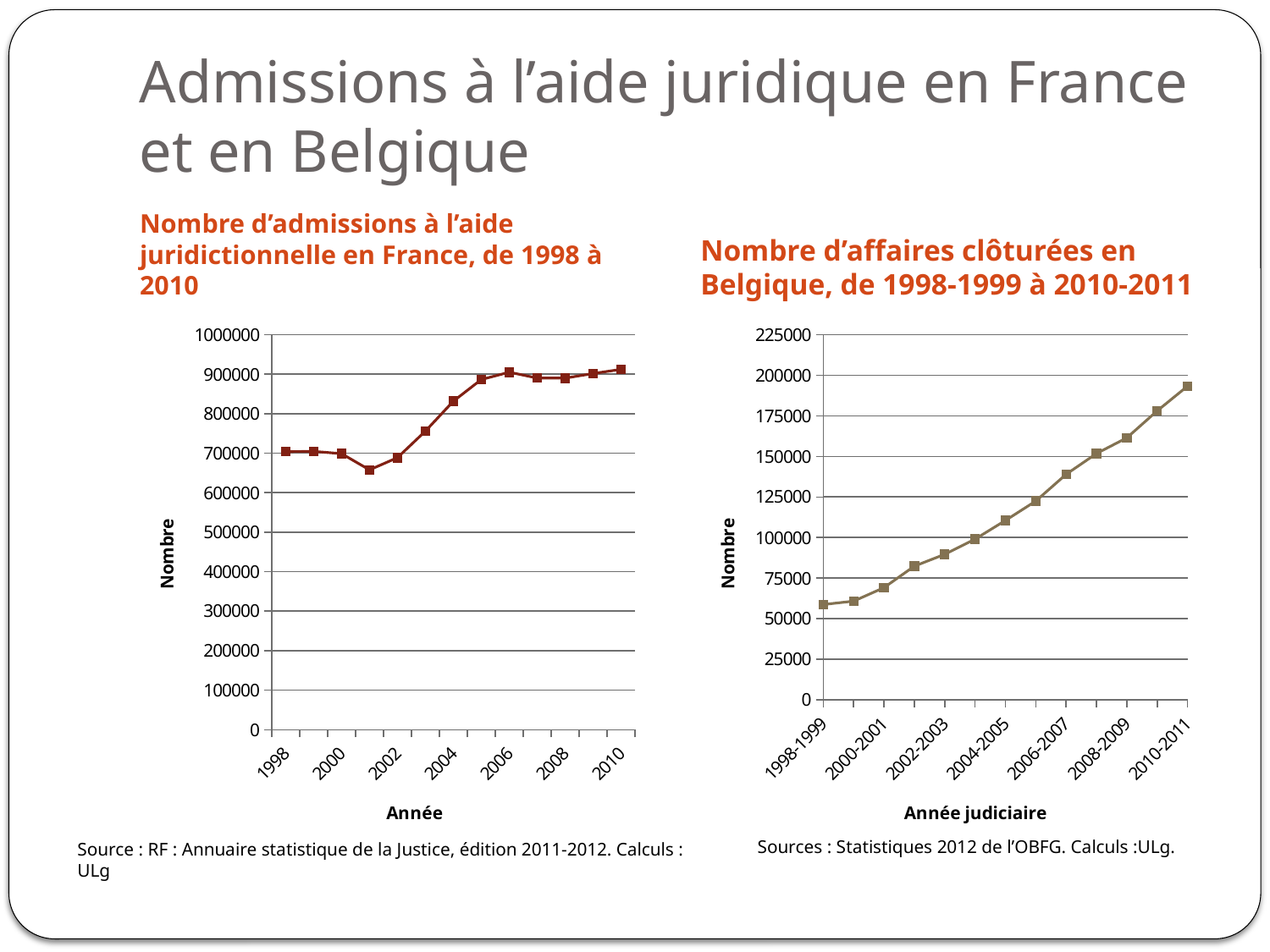
In the right chart (Belgium), is the value for 1998-1999 greater or less than 75000? less In the right chart (Belgium), is the value for 2010-2011 greater or less than 175000? greater In the left chart (France), is the value for 2006 greater or less than 800000? greater In the right chart (Belgium), which judicial year has the highest value? 2010-2011 What kind of chart is the right chart, 'Nombre d'affaires clôturées en Belgique, de 1998-1999 à 2010-2011'? Line chart What kind of chart is the left chart, 'Nombre d'admissions à l'aide juridictionnelle en France, de 1998 à 2010'? Line chart In the right chart (Belgium), how many judicial years are plotted? 13 In the right chart (Belgium), do the values rise or fall from 1998-1999 to 2010-2011? Rise In the left chart (France), which year has the lowest value? 2001 What is the label of the horizontal axis of the right chart (Belgium)? Année judiciaire In the right chart (Belgium), which judicial year has the lowest value? 1998-1999